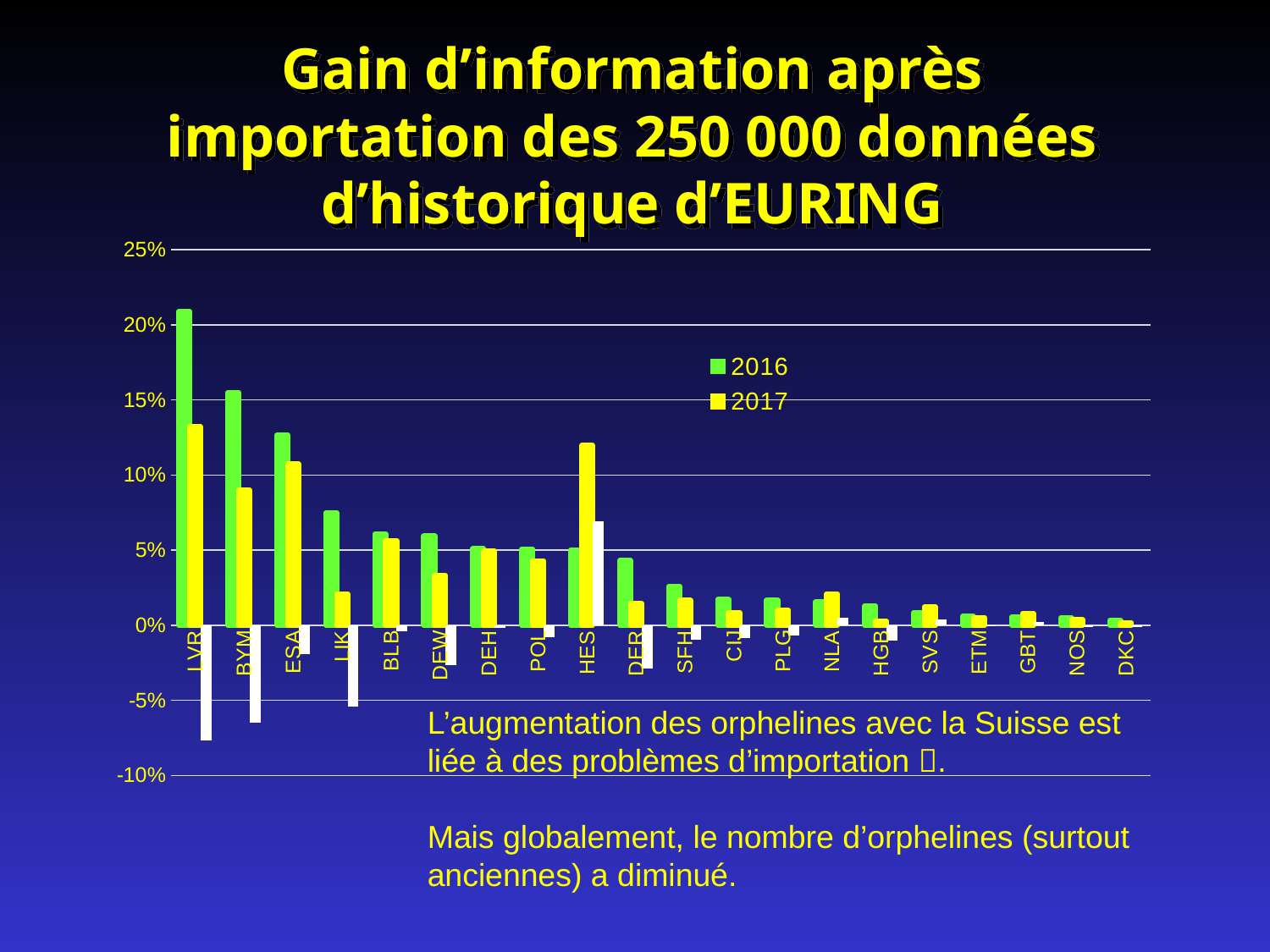
Is the 2017 value for HES greater or less than 10%? greater What kind of chart is shown on the slide? bar chart Which colour represents the 2017 series in the chart legend? yellow How many series does the chart legend list? 2 Is the 2016 value for BYM greater or less than 15%? greater Which category has the highest value for the 2016 series? LVR Is the 2016 value for LVR greater or less than 20%? greater Which is larger, the 2017 value for HES or the 2017 value for DEH? HES How many categories are shown along the x axis of the chart? 20 Do the 2016 values generally rise or fall from left to right along the x axis? fall